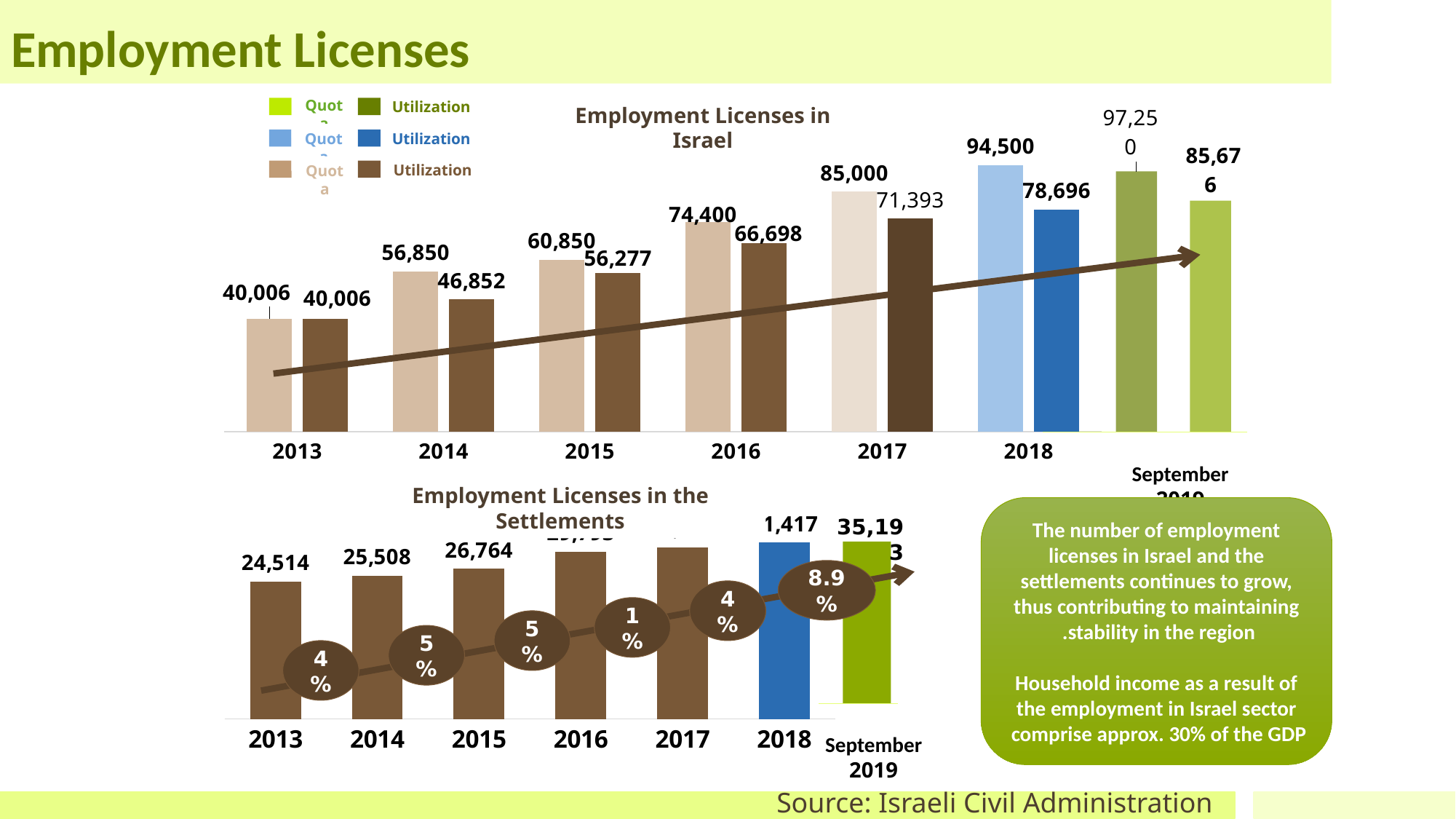
In the 'Employment Licenses in Israel' chart, what is the Quota value for 2017? 85,000 What type of chart is 'Employment Licenses in Israel'? Bar chart In the 'Employment Licenses in Israel' chart, which is larger: the Quota for 2014 or the Utilization for 2015? Quota for 2014 In the 'Employment Licenses in Israel' chart, what is the difference between the Quota and Utilization values for 2016? 7,702 In the 'Employment Licenses in Israel' chart, do the Quota values rise or fall from 2013 to September 2019? Rise In the 'Employment Licenses in Israel' chart, what is the Utilization value for 2018? 78,696 In the 'Employment Licenses in the Settlements' chart, what is the value for 2015? 26,764 In the 'Employment Licenses in the Settlements' chart, what is the difference between the 2014 and 2013 values? 994 In the 'Employment Licenses in Israel' chart, which year has the lowest Quota value? 2013 In the 'Employment Licenses in Israel' chart, what is the Utilization value for 2014? 46,852 In the 'Employment Licenses in Israel' chart, which period has the highest Utilization value? September 2019 How many time periods are shown on the x axis of the 'Employment Licenses in Israel' chart? 7